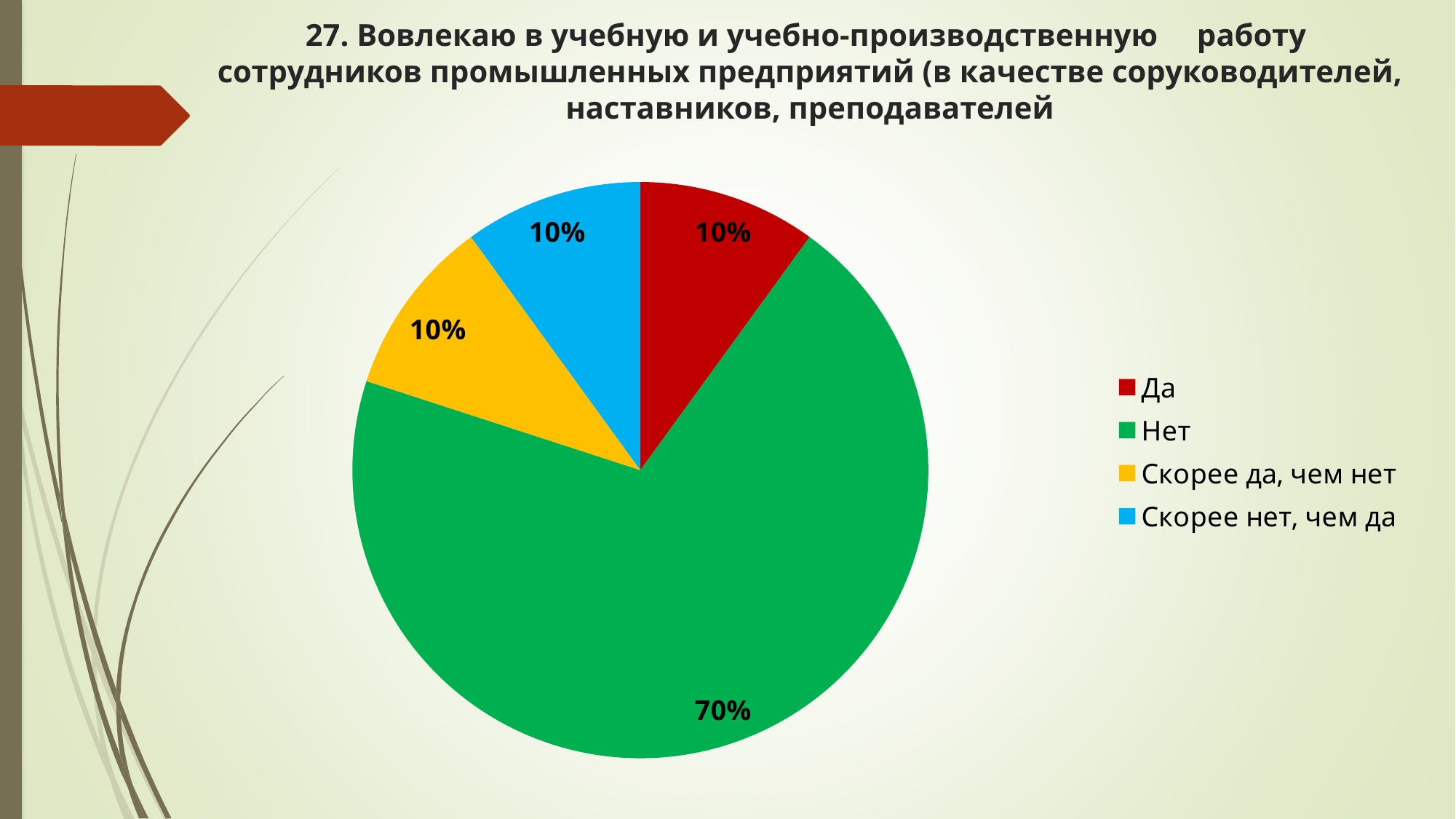
What colour is the slice for "Нет"? green Which is larger, the value for "Нет" or the value for "Скорее нет, чем да"? Нет How many categories does the pie chart have? 4 What is the difference between the values for "Нет" and "Да"? 60% What share of the pie does "Нет" take? 70% What kind of chart is shown on the slide? pie chart What is the value for "Да"? 10% Which category has the largest slice of the pie? Нет What is the value for "Скорее да, чем нет"? 10% What is the combined share of "Да" and "Скорее да, чем нет"? 20% Which legend entry is shown in yellow? Скорее да, чем нет What is the value for "Скорее нет, чем да"? 10%